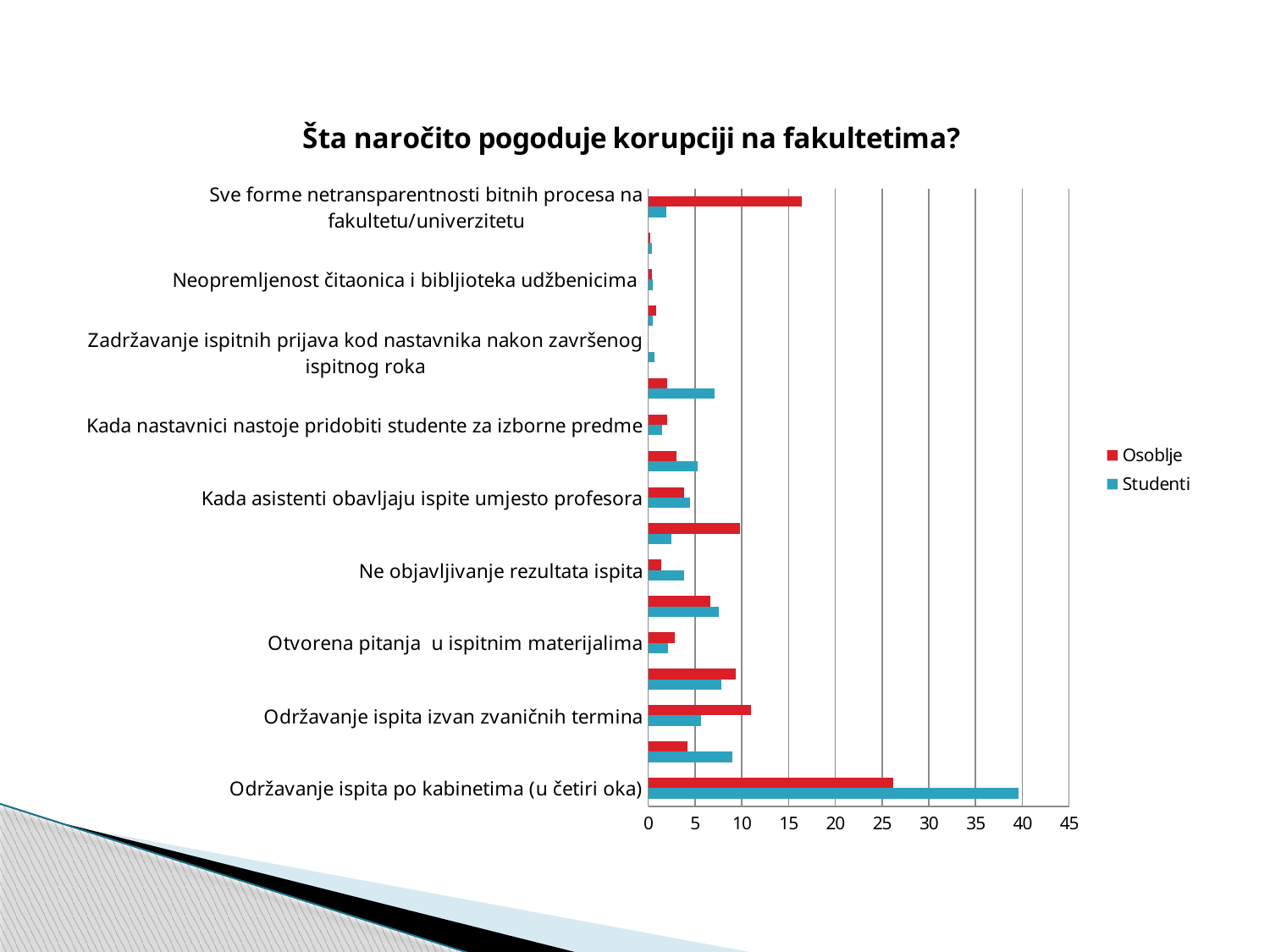
Which category has the highest Studenti value? Održavanje ispita po kabinetima (u četiri oka) Which category has the highest Osoblje value? Održavanje ispita po kabinetima (u četiri oka) Is the Osoblje value for Sve forme netransparentnosti bitnih procesa na fakultetu/univerzitetu greater or less than 15? greater For Održavanje ispita izvan zvaničnih termina, which is larger: the Osoblje value or the Studenti value? Osoblje What kind of chart is shown on the slide? bar chart What is the title of the chart? Šta naročito pogoduje korupciji na fakultetima? Which series is shown in blue in the legend? Studenti How many series does the legend list? 2 Is the Osoblje value for Održavanje ispita po kabinetima (u četiri oka) greater or less than 30? less For Sve forme netransparentnosti bitnih procesa na fakultetu/univerzitetu, which is larger: the Osoblje value or the Studenti value? Osoblje Is the Studenti value for Održavanje ispita po kabinetima (u četiri oka) greater or less than 35? greater For Održavanje ispita po kabinetima (u četiri oka), which is larger: the Osoblje value or the Studenti value? Studenti